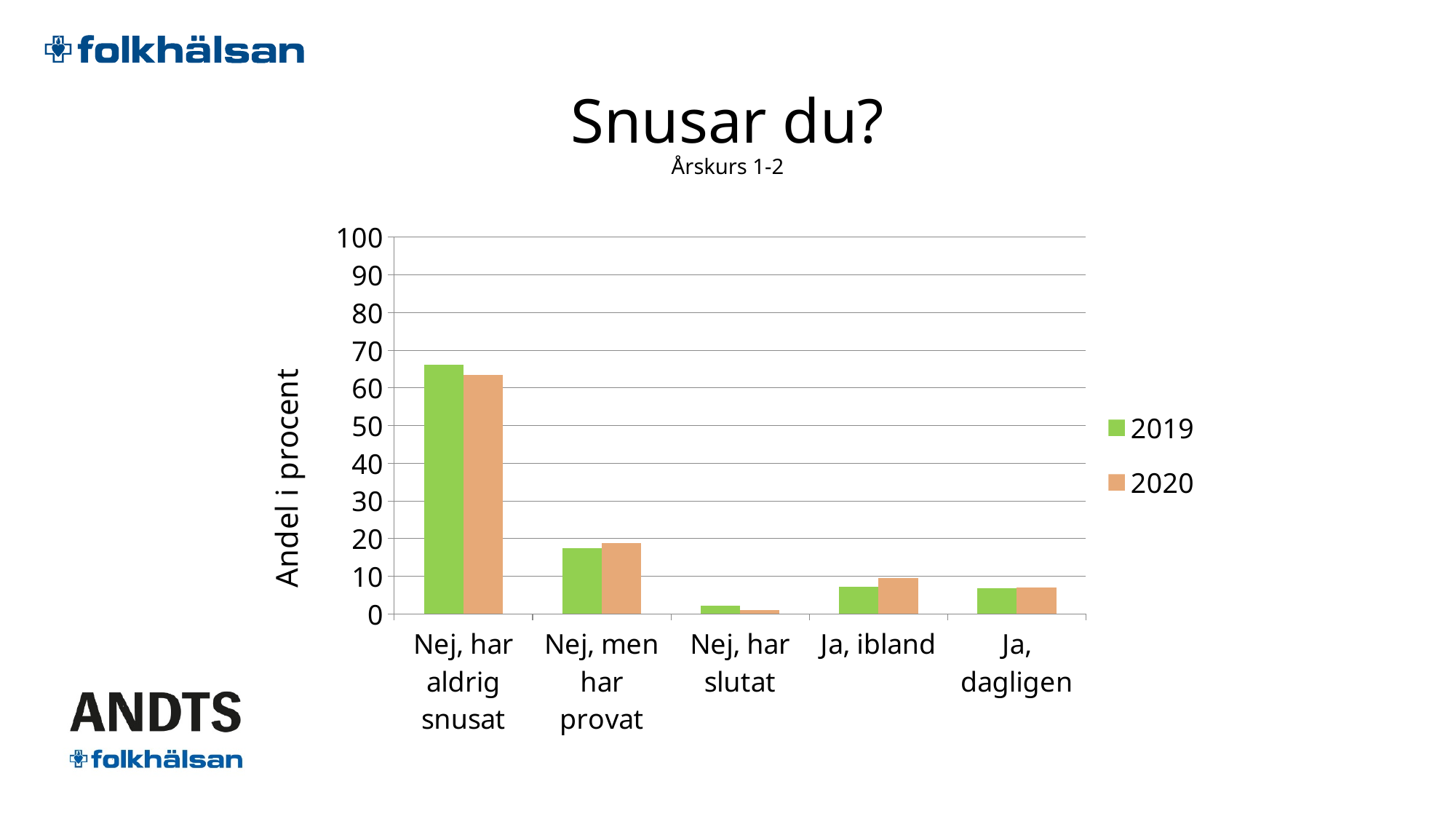
Is the 2019 value for 'Ja, ibland' greater or less than 10? less Which category has the lowest value for 2019? Nej, har slutat How many categories are shown on the x axis? 5 Is the 2020 value for 'Nej, men har provat' greater or less than 10? greater Which category has the lowest value for 2020? Nej, har slutat For 'Nej, men har provat', which year has the larger value, 2019 or 2020? 2020 Which category has the highest value for 2019? Nej, har aldrig snusat How many series does the legend list? 2 What is the label of the vertical axis? Andel i procent What kind of chart is shown on the slide? bar chart For 'Nej, har aldrig snusat', which year has the larger value, 2019 or 2020? 2019 Is the 2019 value for 'Nej, har aldrig snusat' greater or less than 60? greater